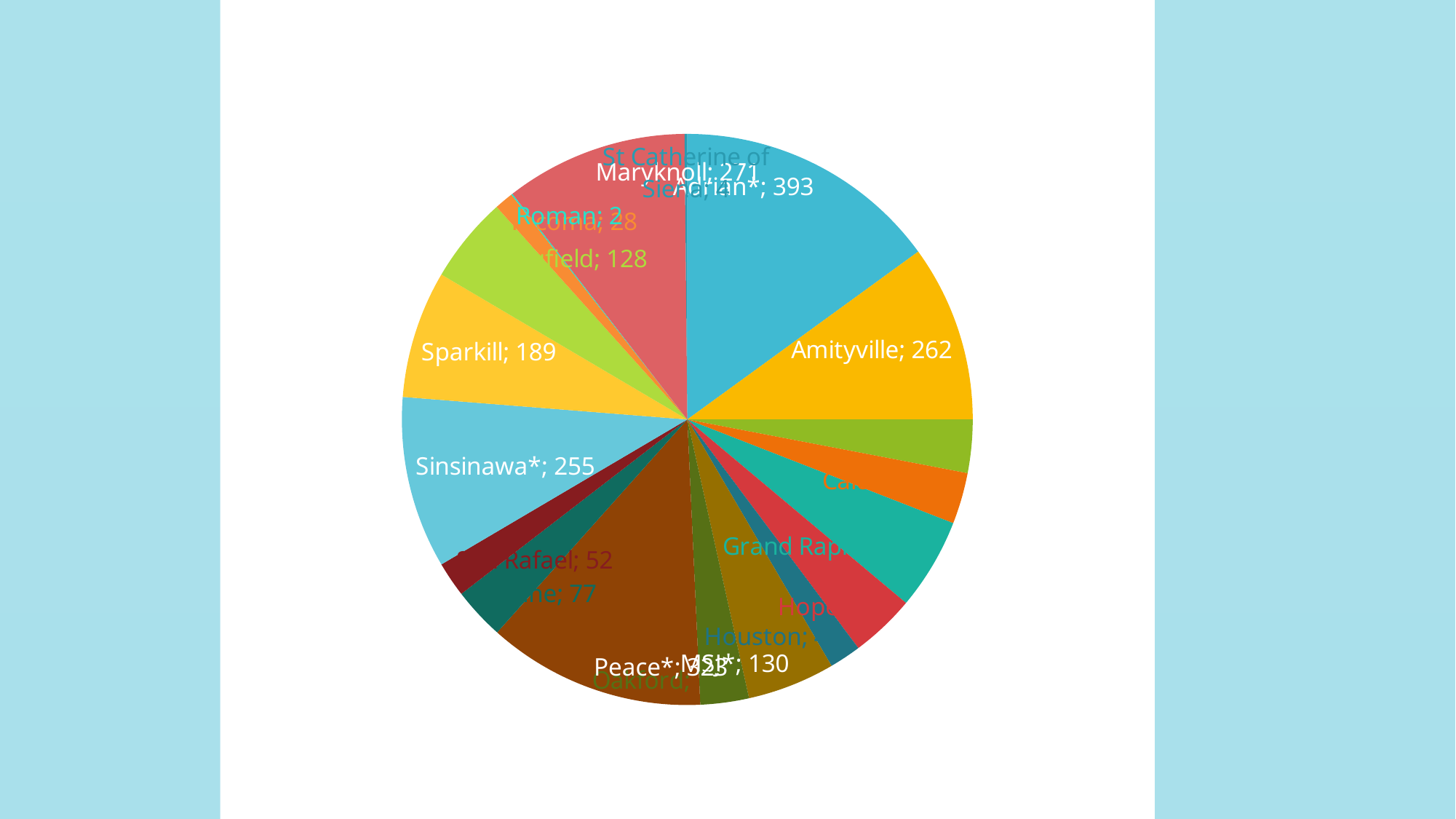
What kind of chart is shown on the slide? pie chart Which labelled slice has the largest value in the pie chart? Adrian* What value is shown for MSJ* in the pie chart? 130 What value is shown for the Adrian* slice of the pie chart? 393 What is the difference between the values for Maryknoll and Sinsinawa*? 16 What colour is the Adrian* slice of the pie chart? blue Which has the larger value, Sparkill or MSJ*? Sparkill What value is shown for Sinsinawa* in the pie chart? 255 What value is shown for Sparkill in the pie chart? 189 What value is shown for Maryknoll in the pie chart? 271 What value is shown for Amityville in the pie chart? 262 What is the difference between the values for Adrian* and Amityville? 131